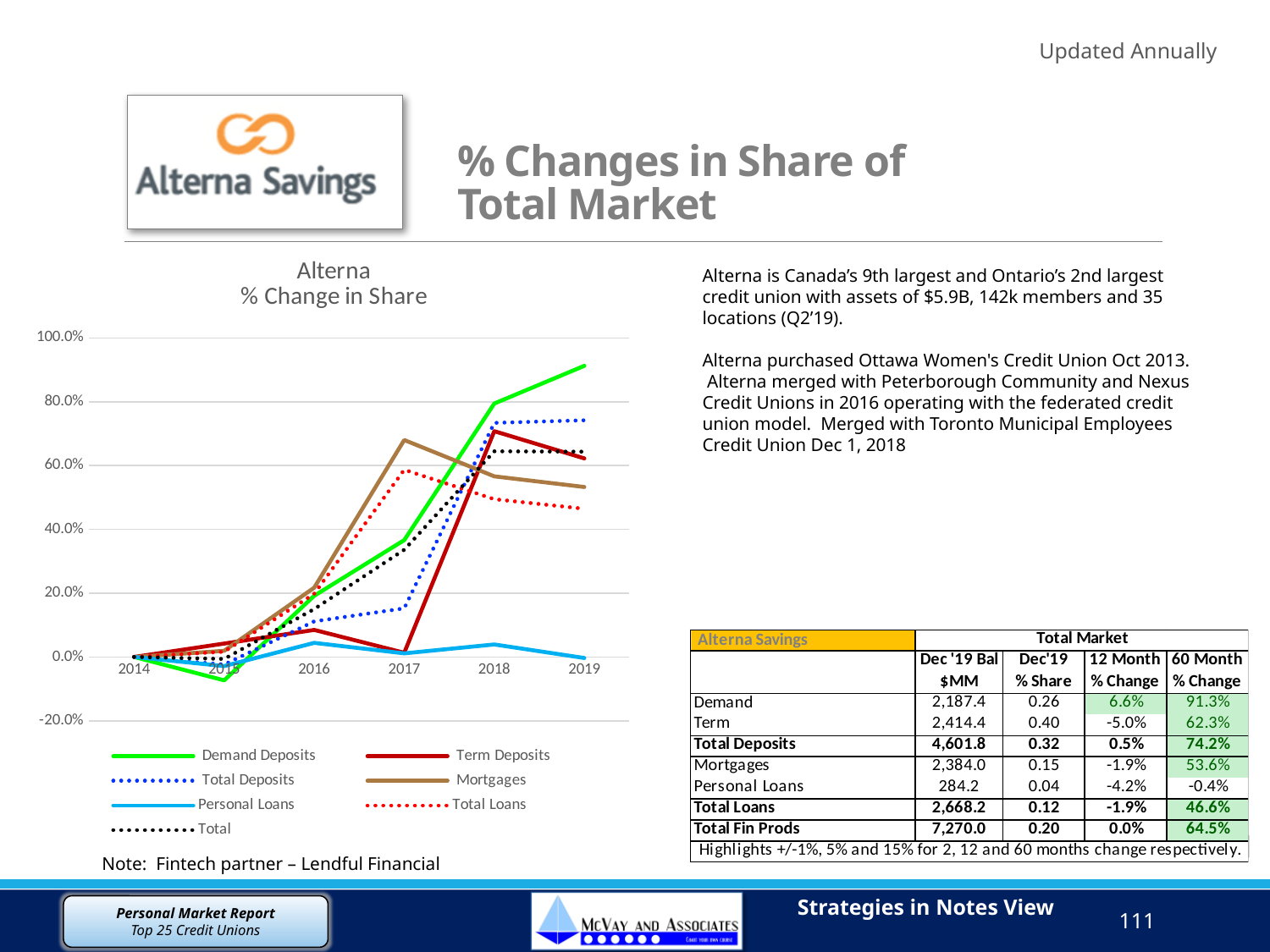
Is the value for Total Loans in 2019 greater or less than 60.0%? less How many years are plotted along the x axis of the chart? 6 Which is larger in 2019, Demand Deposits or Personal Loans? Demand Deposits Is the value for Personal Loans in 2019 greater or less than 20.0%? less Which series has the lowest value in 2019? Personal Loans Is the value for Demand Deposits in 2019 greater or less than 80.0%? greater Does the Demand Deposits series rise or fall between 2016 and 2019? rise Which series has the highest value in 2019? Demand Deposits What kind of chart is shown on the slide? line chart How many series does the legend of the chart list? 7 What is the title of the chart? Alterna % Change in Share